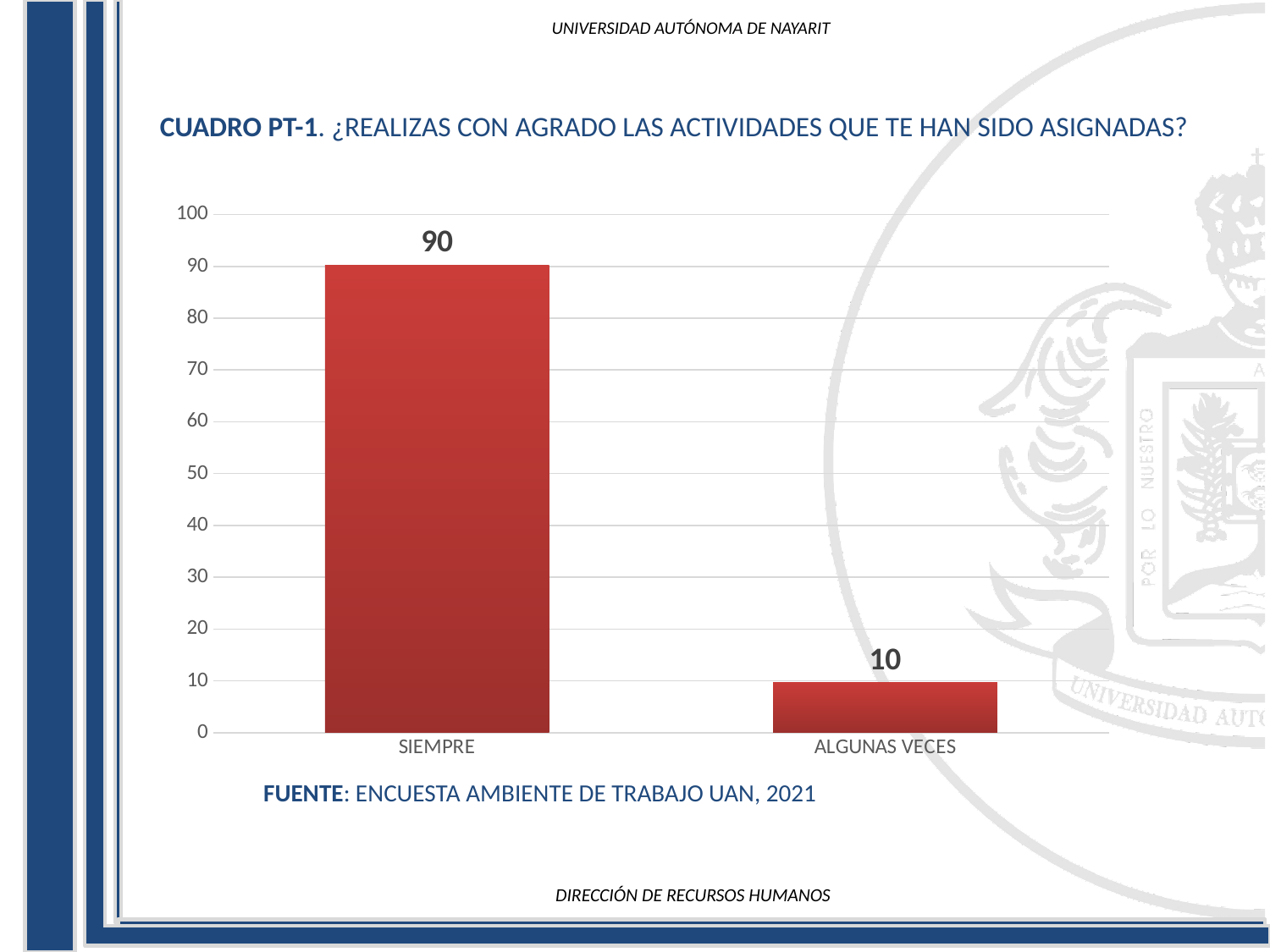
Which category has the highest value? SIEMPRE Is the value for ALGUNAS VECES greater or less than 20? less What is the value for SIEMPRE? 90 What is the difference between the values for SIEMPRE and ALGUNAS VECES? 80 What is the value for ALGUNAS VECES? 10 Which category has the lowest value? ALGUNAS VECES Which is larger, the value for SIEMPRE or the value for ALGUNAS VECES? SIEMPRE What kind of chart is shown on the slide? bar chart How many categories are shown on the x axis? 2 Is the value for SIEMPRE greater or less than 50? greater What is the total of the two bars? 100 What source is cited below the chart? ENCUESTA AMBIENTE DE TRABAJO UAN, 2021